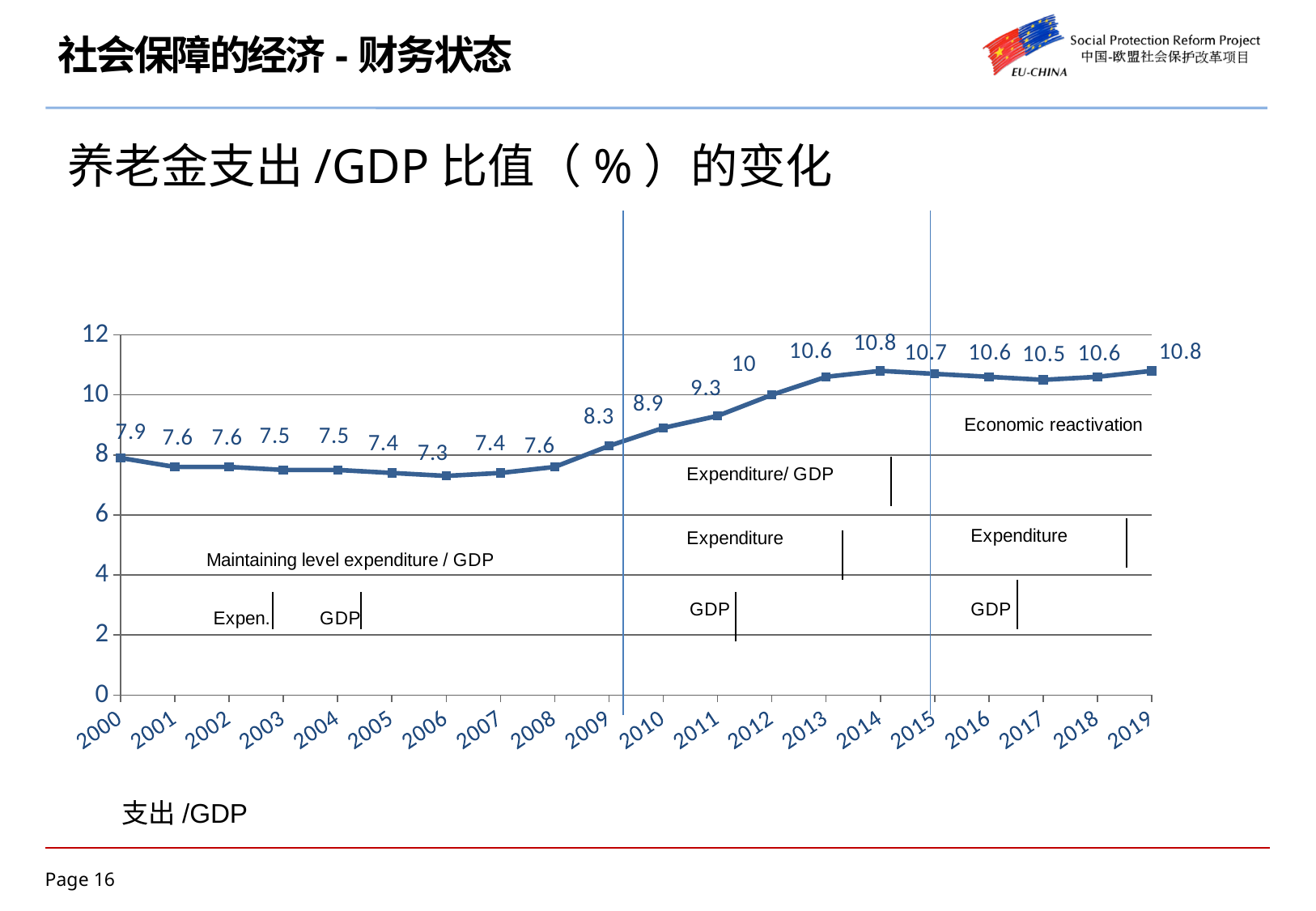
Which year has the lowest value on the chart? 2006 Does the value rise or fall from 2008 to 2014? rise What is the difference between the values for 2014 and 2000? 2.9 What is the difference between the values for 2011 and 2010? 0.4 What is the value plotted for 2012? 10 What is the value plotted for 2017? 10.5 What is the value plotted for 2009? 8.3 How many years are plotted on the x axis? 20 What kind of chart is shown on the slide? line chart Which year has the larger value, 2013 or 2015? 2015 What is the pension expenditure/GDP value for 2000? 7.9